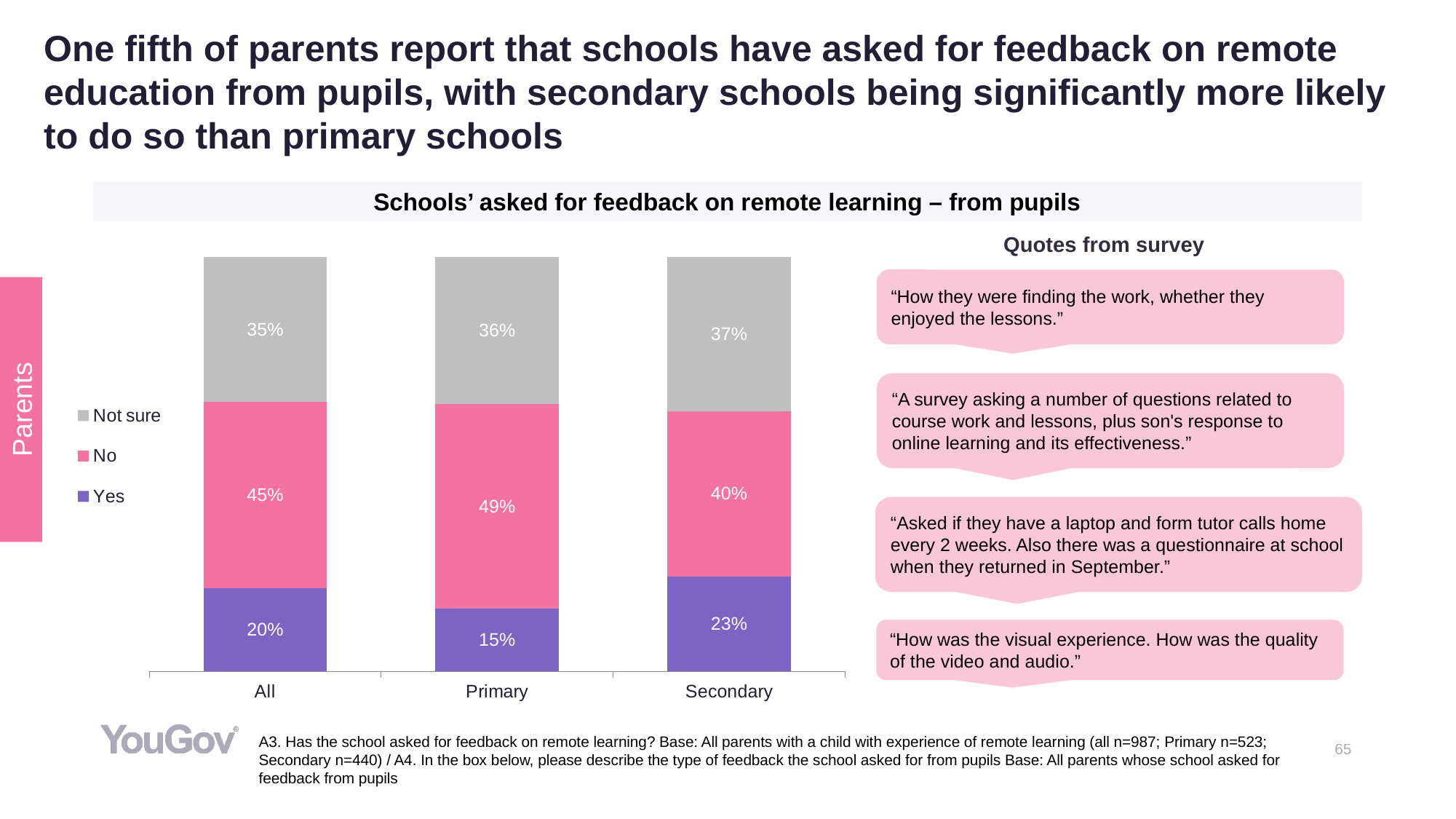
What percentage of parents in the 'All' category answered 'Yes'? 20% Which category has the highest 'Yes' value? Secondary Which category has the lowest 'Yes' value? Primary Which is larger, the 'No' value for Primary or the 'No' value for Secondary? Primary What is the 'No' value for Primary? 49% What is the total of the stacked bar for 'All'? 100% What kind of chart is shown? Stacked bar chart What is the 'Not sure' value for Secondary? 37% What is the difference between the 'Yes' values for Secondary and Primary? 8 percentage points How many series does the legend list? 3 How many categories are shown on the x axis? 3 What is the title of the chart? Schools' asked for feedback on remote learning – from pupils